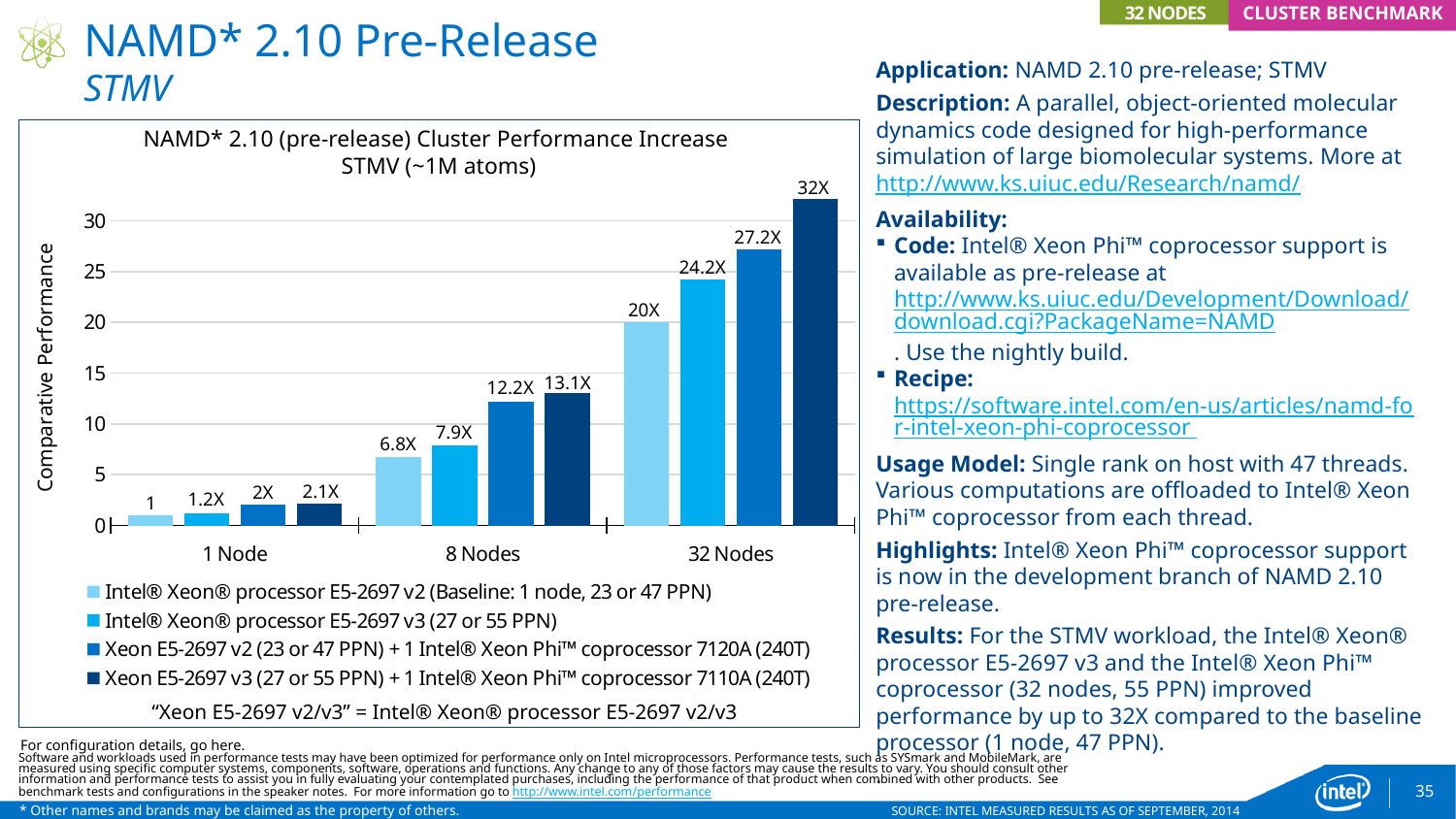
Which series has the lowest value at 8 Nodes? Intel® Xeon® processor E5-2697 v2 (Baseline: 1 node, 23 or 47 PPN) How many node-count categories are shown on the x axis of the chart? 3 Which is larger: the 8 Nodes value for Xeon E5-2697 v2 + Xeon Phi 7120A or the 8 Nodes value for Intel® Xeon® processor E5-2697 v3? Xeon E5-2697 v2 + Xeon Phi 7120A What is the difference between the 32 Nodes values for Xeon E5-2697 v3 + Xeon Phi 7110A and Xeon E5-2697 v2 + Xeon Phi 7120A? 4.8X What is the value for Intel® Xeon® processor E5-2697 v3 (27 or 55 PPN) at 8 Nodes? 7.9X What is the value for Intel® Xeon® processor E5-2697 v2 (Baseline) at 32 Nodes? 20X What type of chart is shown on the slide? bar chart How many series does the chart legend list? 4 What is the value for Xeon E5-2697 v3 (27 or 55 PPN) + 1 Intel® Xeon Phi™ coprocessor 7110A (240T) at 32 Nodes? 32X What is the title of the chart? NAMD* 2.10 (pre-release) Cluster Performance Increase STMV (~1M atoms) Which series has the highest value at 32 Nodes? Xeon E5-2697 v3 (27 or 55 PPN) + 1 Intel® Xeon Phi™ coprocessor 7110A (240T) What is the value for Xeon E5-2697 v2 (23 or 47 PPN) + 1 Intel® Xeon Phi™ coprocessor 7120A (240T) at 1 Node? 2X